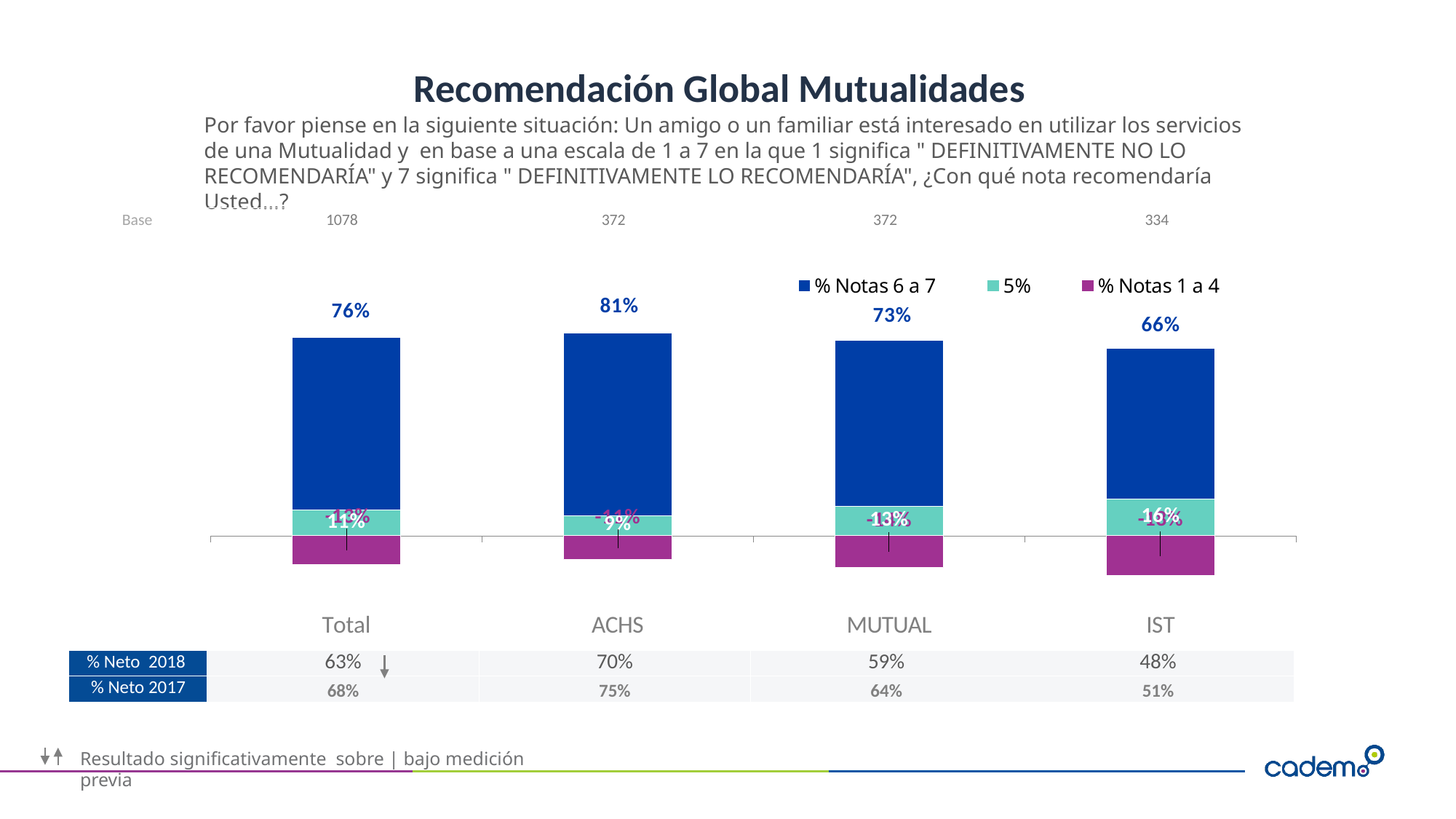
How many categories are shown on the x axis of the chart? 4 What kind of chart is shown on the slide? Stacked bar chart What is the value of % Notas 6 a 7 for IST? 66% What is the value of % Notas 6 a 7 for Total? 76% Which has a larger % Notas 6 a 7 value, Total or MUTUAL? Total How many series does the chart legend list? 3 What is the value of % Notas 6 a 7 for ACHS? 81% Which category has the lowest % Notas 6 a 7 value? IST Which category has the highest % Notas 6 a 7 value? ACHS What is the difference between the % Notas 6 a 7 values for ACHS and MUTUAL? 8% What colour represents the % Notas 1 a 4 series in the chart? Magenta (purple) What is the % Neto 2018 value shown for MUTUAL in the table below the chart? 59%